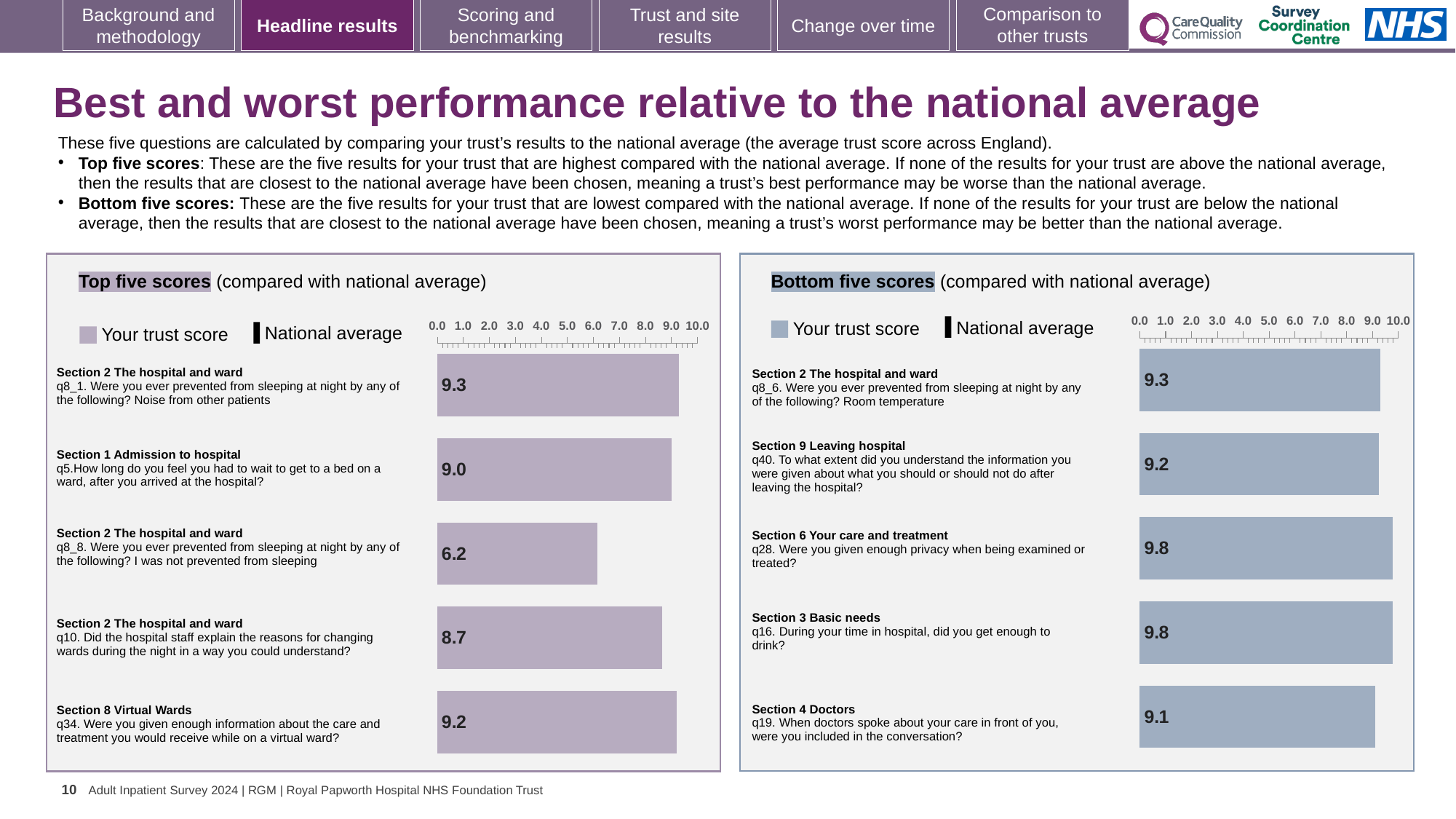
In the Bottom five scores chart, what is the highest trust score shown? 9.8 In the Bottom five scores chart, what is the trust score for q40 (understanding information about what to do after leaving hospital)? 9.2 In the Top five scores chart, which is larger: the trust score for q10 or for q34? q34 In the Top five scores chart, what is the trust score for q5 (how long you had to wait to get to a bed on a ward)? 9.0 How many bars are plotted in the Bottom five scores chart? 5 In the Top five scores chart, what is the difference between the trust scores for q8_1 and q8_8? 3.1 In the Bottom five scores chart, what is the difference between the trust scores for q28 and q19? 0.7 In the Top five scores chart, what is the trust score for q8_1 (noise from other patients)? 9.3 In the Top five scores chart, which question has the lowest trust score? q8_8. Were you ever prevented from sleeping at night by any of the following? I was not prevented from sleeping In the Bottom five scores chart, what is the trust score for q19 (doctors including you in the conversation)? 9.1 In the Top five scores chart, is the trust score for q8_8 greater or less than 7.0? less What kind of chart is used in the Top five scores panel? Bar chart